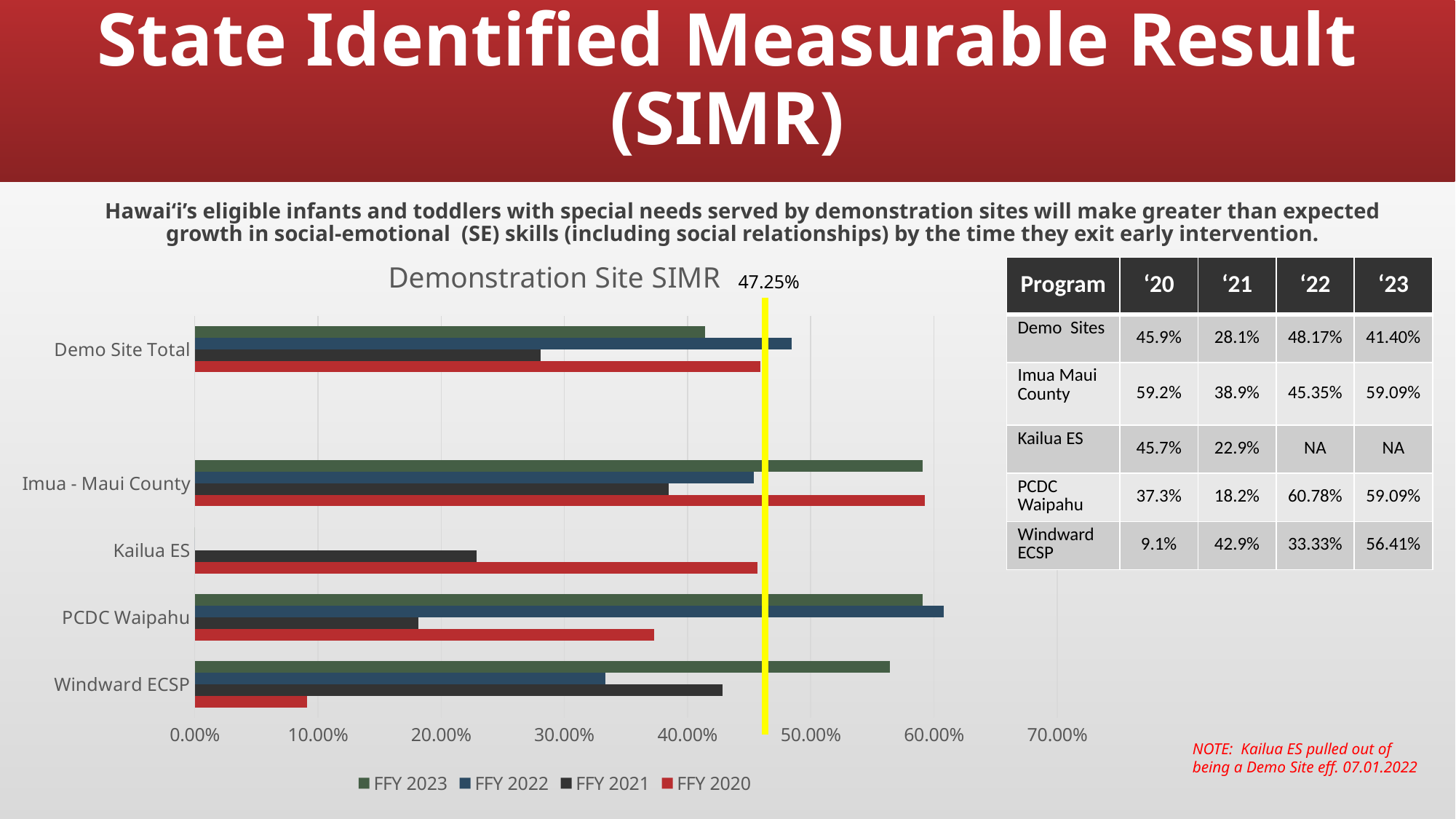
Is the FFY 2022 value for PCDC Waipahu greater or less than 60.00%? greater What is the title of the chart? Demonstration Site SIMR Which program has the lowest FFY 2020 bar? Windward ECSP How many series does the chart legend list? 4 Which program has the highest FFY 2022 bar? PCDC Waipahu What kind of chart is shown on the slide? bar chart What value is labelled on the yellow vertical reference line in the chart? 47.25% Is the FFY 2020 value for Windward ECSP greater or less than 10.00%? less For Windward ECSP, which is larger: the FFY 2023 bar or the FFY 2021 bar? FFY 2023 Which program has the highest FFY 2020 bar? Imua - Maui County Is the FFY 2021 value for Demo Site Total greater or less than 30.00%? less How many program categories are shown on the chart's vertical axis? 5